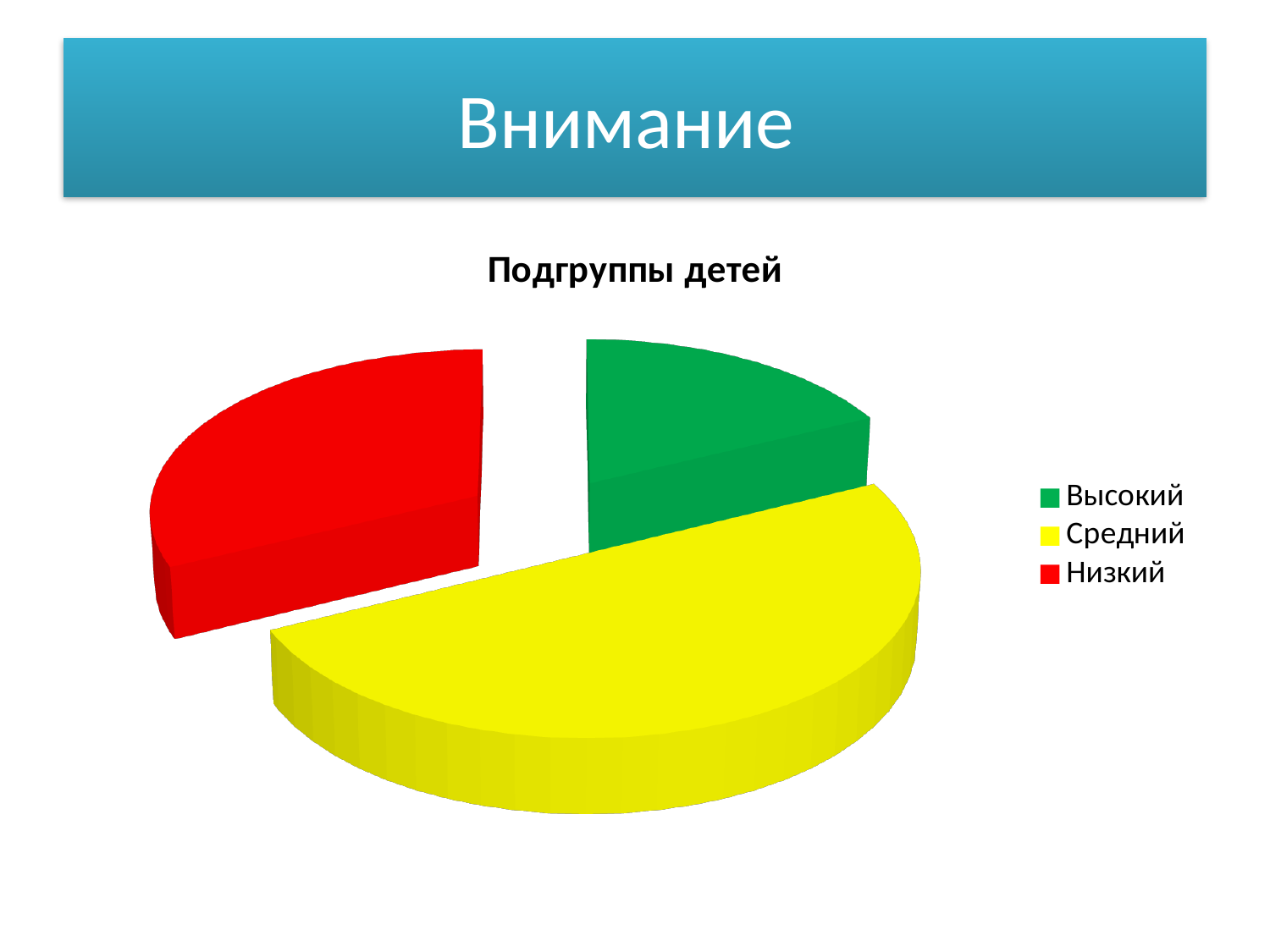
How many entries does the legend list? 3 Which category has the largest slice of the pie? Средний Which of the two is larger: the slice for Средний or the slice for Высокий? Средний What is the title of the chart? Подгруппы детей How many slices does the pie chart have? 3 What kind of chart is shown on the slide? pie chart Which of the two is larger: the slice for Низкий or the slice for Средний? Средний What colour is the slice for Низкий? red